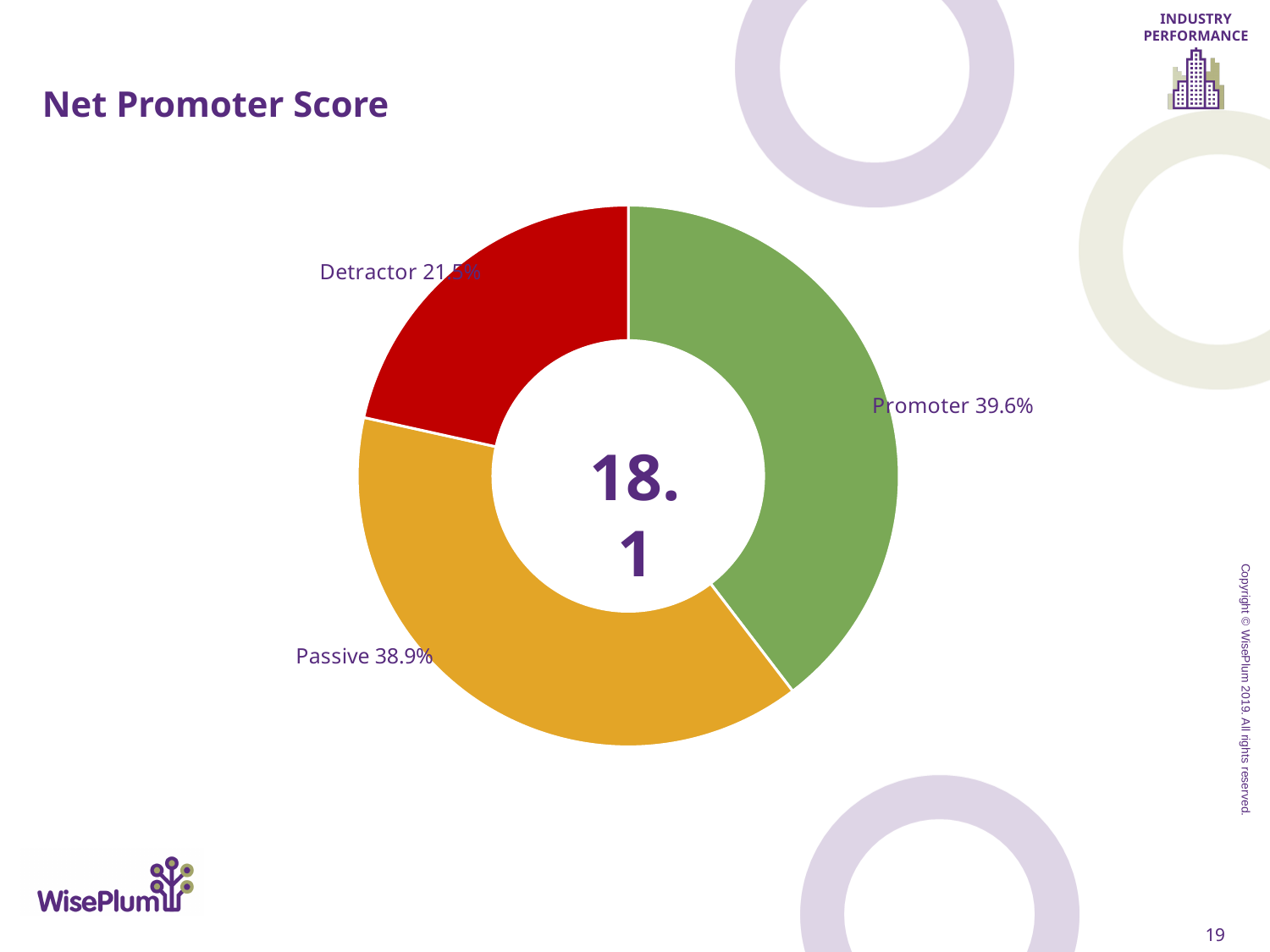
What colour represents the Detractor segment in the chart? Red What Net Promoter Score is shown in the centre of the donut chart? 18.1 What percentage of respondents are Passives in the Net Promoter Score chart? 38.9% How many categories are shown in the Net Promoter Score chart? 3 What percentage of respondents are Promoters in the Net Promoter Score chart? 39.6% By how many percentage points does the Promoter share exceed the Passive share? 0.7 What kind of chart is used to show the Net Promoter Score breakdown? Donut (pie) chart What is the title of the slide containing the chart? Net Promoter Score Which share is larger, Promoter or Passive? Promoter Which category has the largest share in the Net Promoter Score chart? Promoter Which category has the smallest share in the Net Promoter Score chart? Detractor